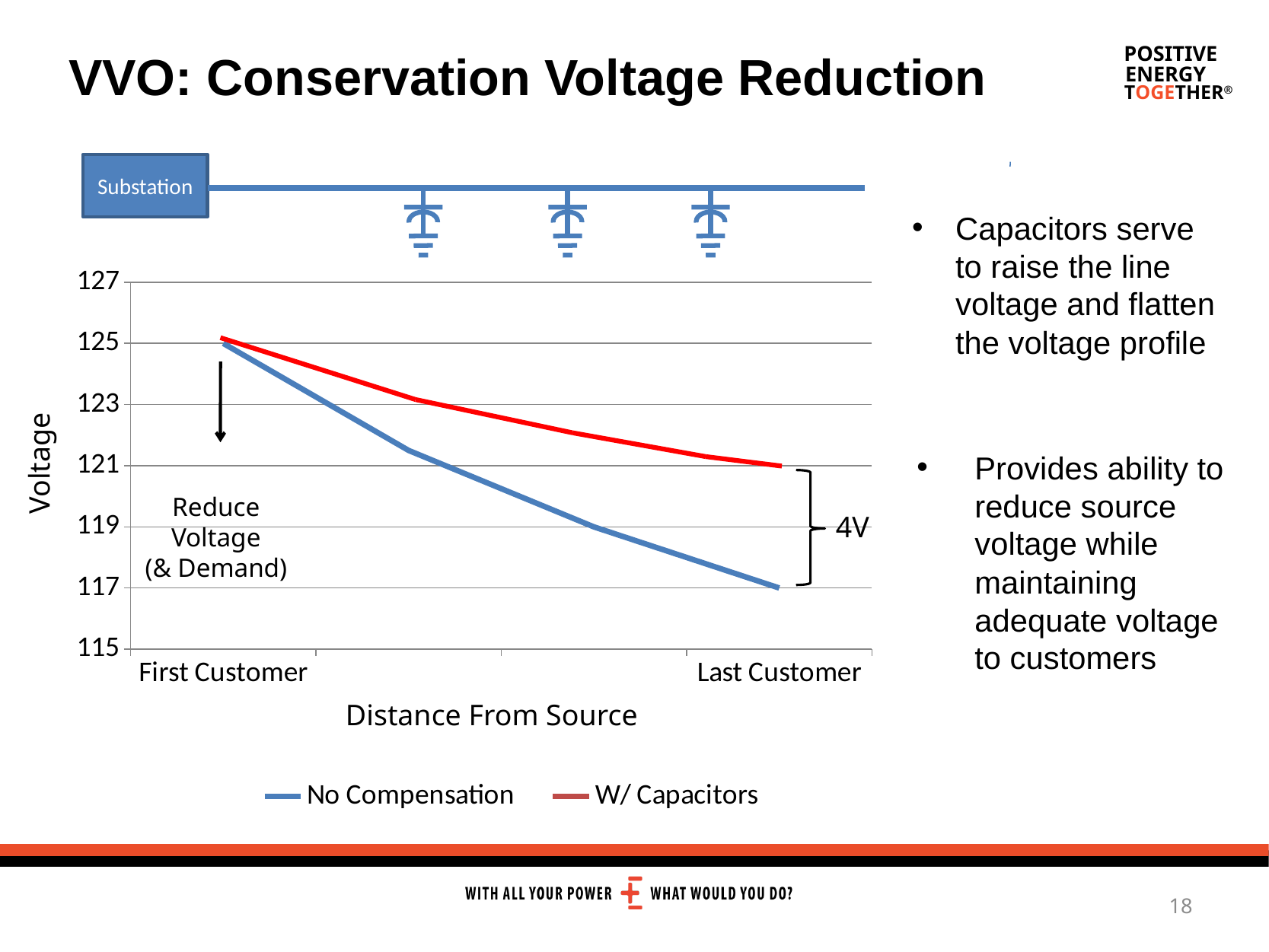
How many series does the chart legend list? 2 Which series has the higher voltage at the Last Customer, No Compensation or W/ Capacitors? W/ Capacitors Is the W/ Capacitors voltage at the midpoint of the line greater or less than 121? greater What is the voltage of the W/ Capacitors line at the Last Customer? 121 What is the difference between the W/ Capacitors and No Compensation voltages at the Last Customer, as annotated on the chart? 4V What is the voltage of the No Compensation line at the Last Customer? 117 What is the voltage of the No Compensation line at the First Customer? 125 What are the two series named in the chart legend? No Compensation and W/ Capacitors Does the No Compensation voltage rise or fall as distance from the source increases? Fall What kind of chart is shown on the slide? Line chart What is the label of the chart's x axis? Distance From Source Is the No Compensation voltage at the midpoint of the line greater or less than 123? less